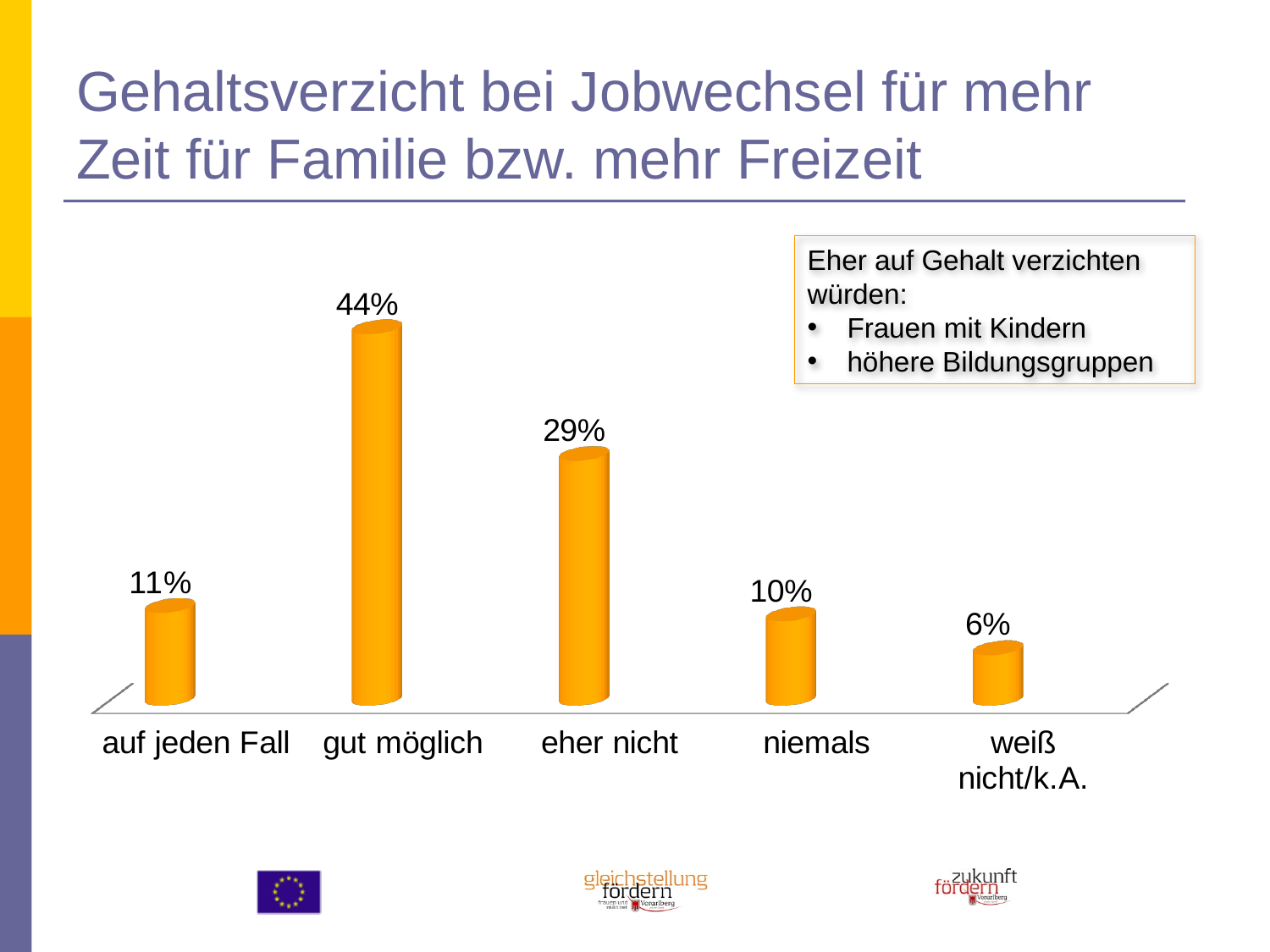
What is the value for "auf jeden Fall"? 11% What is the value for "niemals"? 10% What is the value for "weiß nicht/k.A."? 6% What is the value for "gut möglich"? 44% What colour are the bars in the chart? orange What kind of chart is shown on the slide? bar chart What is the difference between the values for "gut möglich" and "eher nicht"? 15% Which category has the highest value? gut möglich How many categories are shown in the chart? 5 What is the difference between the values for "auf jeden Fall" and "niemals"? 1% Which is larger, the value for "eher nicht" or the value for "auf jeden Fall"? eher nicht Which category has the lowest value? weiß nicht/k.A.